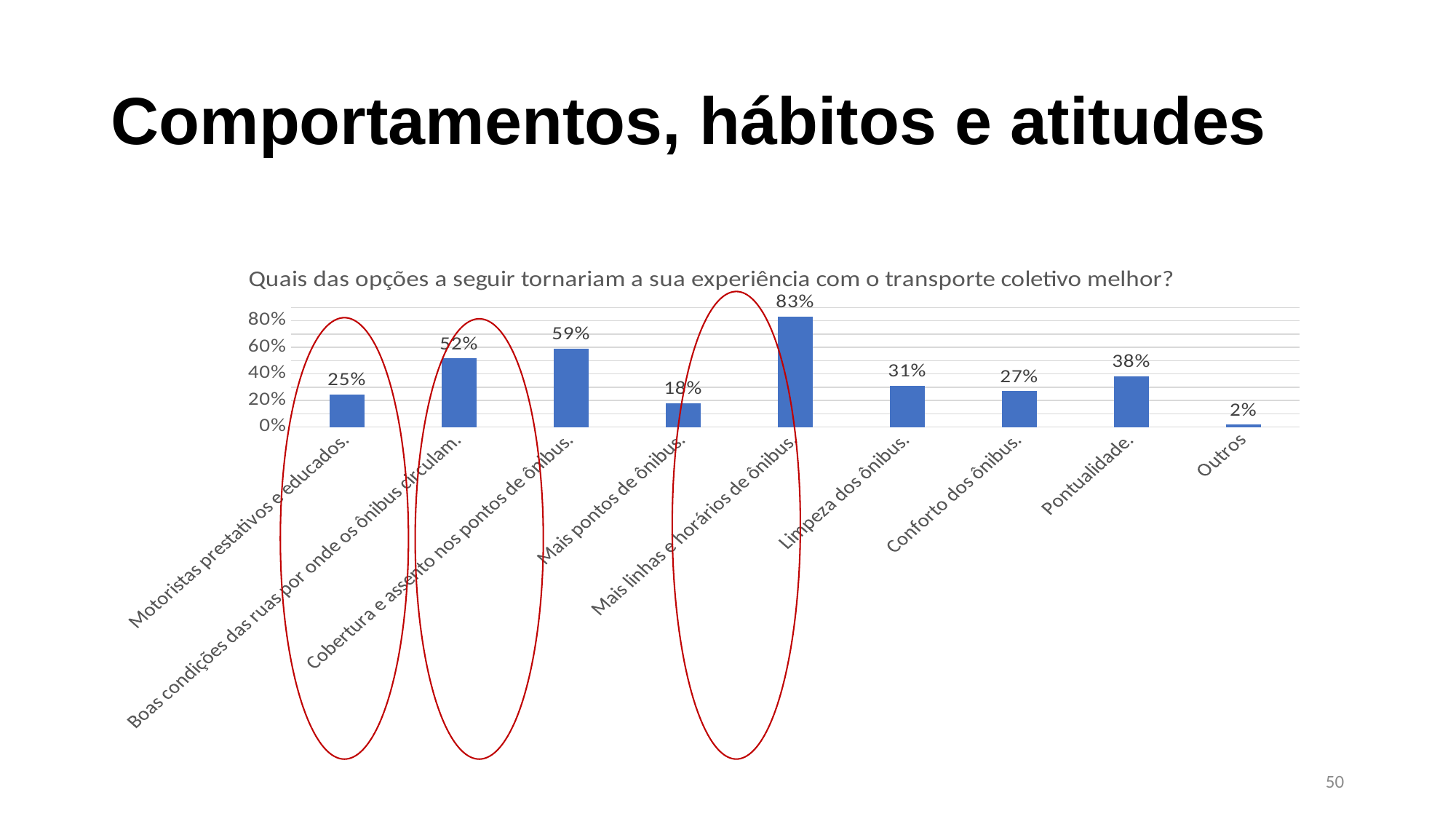
How many categories are circled in red on the chart? 3 What kind of chart is shown on the slide? Bar chart What is the value for "Boas condições das ruas por onde os ônibus circulam"? 52% What is the title of the chart? Quais das opções a seguir tornariam a sua experiência com o transporte coletivo melhor? Which category has the lowest value? Outros Which is larger, "Limpeza dos ônibus" or "Conforto dos ônibus"? Limpeza dos ônibus Which category has the highest value? Mais linhas e horários de ônibus Is the value for "Motoristas prestativos e educados" greater or less than 40%? less What is the difference between "Cobertura e assento nos pontos de ônibus" and "Mais pontos de ônibus"? 41% What is the value for "Mais linhas e horários de ônibus"? 83% What is the value for "Pontualidade"? 38% How many categories are shown in the chart? 9